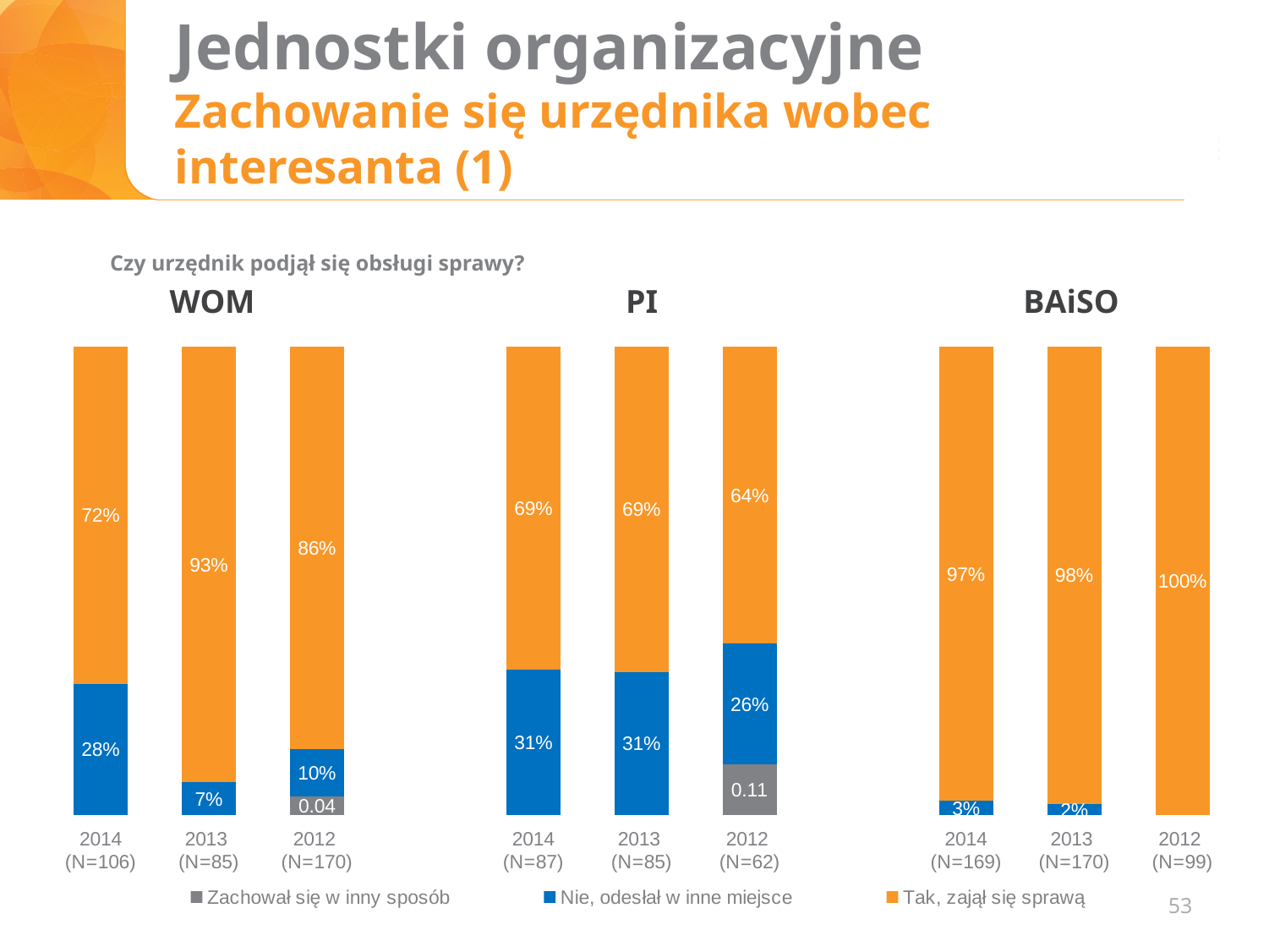
Which colour represents "Tak, zajął się sprawą" in the legend? Orange In the WOM chart, what is the value for "Tak, zajął się sprawą" in 2014 (N=106)? 72% How many series does the legend list? 3 In the BAiSO chart, which is larger: the "Nie, odesłał w inne miejsce" value for 2014 or for 2013? 2014 In the PI chart, which year has the lowest value for "Tak, zajął się sprawą"? 2012 (N=62) In the WOM chart, what is the difference between the "Nie, odesłał w inne miejsce" values for 2014 and 2013? 21% In the WOM chart, what is the value for "Zachował się w inny sposób" in 2012 (N=170)? 0.04 In the BAiSO chart, what is the value for "Tak, zajął się sprawą" in 2012 (N=99)? 100% How many year categories does the PI chart show? 3 What kind of chart is used for WOM, PI and BAiSO? Stacked bar chart In the PI chart, what is the value for "Nie, odesłał w inne miejsce" in 2012 (N=62)? 26% In the WOM chart, which year has the highest value for "Tak, zajął się sprawą"? 2013 (N=85)